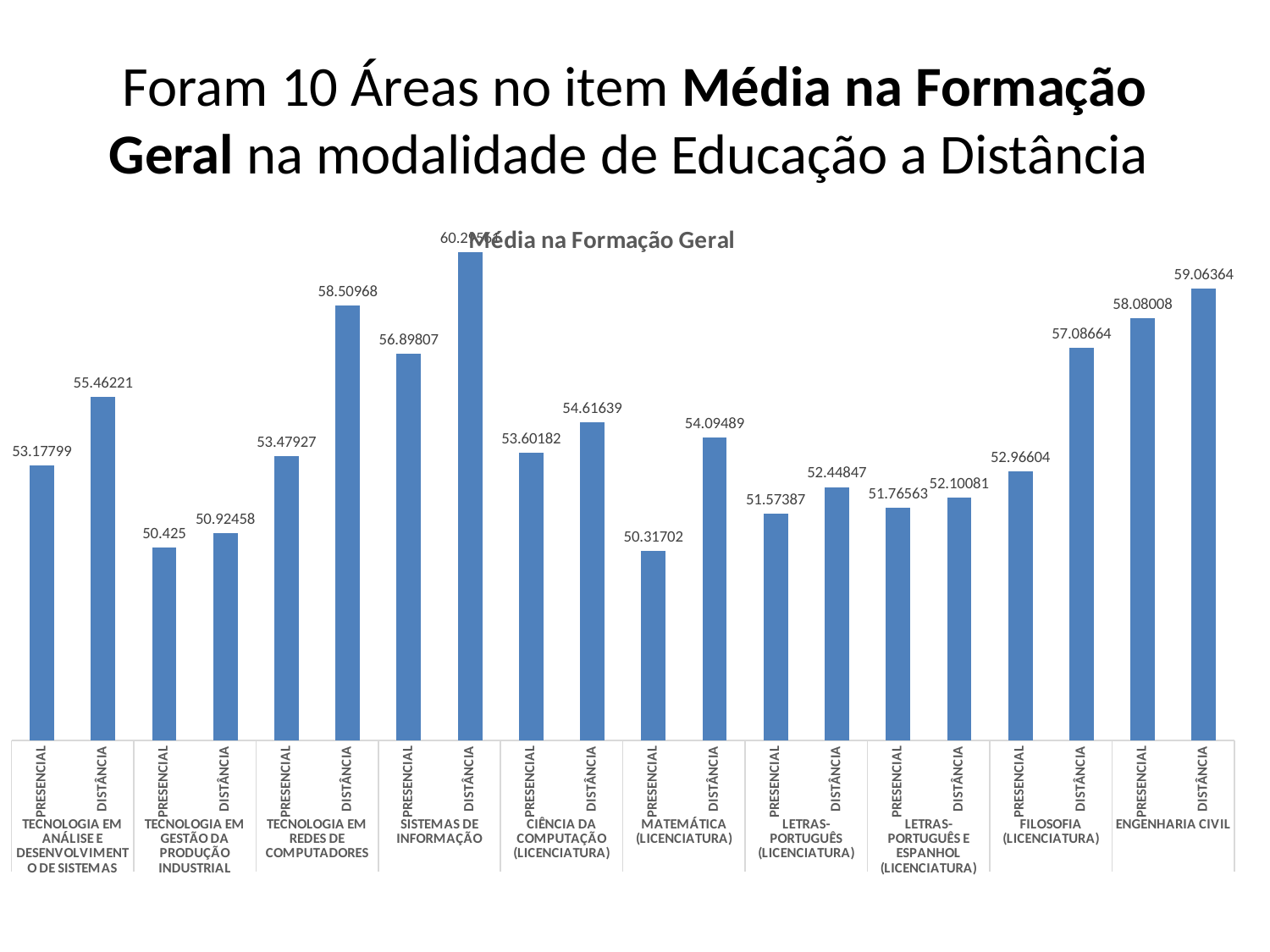
What is the title of the chart? Média na Formação Geral What is the difference between DISTÂNCIA and PRESENCIAL in ENGENHARIA CIVIL? 0.98356 What is the difference between DISTÂNCIA and PRESENCIAL in FILOSOFIA (LICENCIATURA)? 4.1206 Which bar has the lowest value in the chart? PRESENCIAL in MATEMÁTICA (LICENCIATURA) Which is larger in CIÊNCIA DA COMPUTAÇÃO (LICENCIATURA): PRESENCIAL or DISTÂNCIA? DISTÂNCIA What is the value for PRESENCIAL in ENGENHARIA CIVIL? 58.08008 What is the value for DISTÂNCIA in TECNOLOGIA EM REDES DE COMPUTADORES? 58.50968 What is the value for DISTÂNCIA in FILOSOFIA (LICENCIATURA)? 57.08664 What is the value for PRESENCIAL in MATEMÁTICA (LICENCIATURA)? 50.31702 Which bar has the highest value in the chart? DISTÂNCIA in SISTEMAS DE INFORMAÇÃO How many bars are plotted in the chart? 20 What kind of chart is shown on the slide? Bar chart